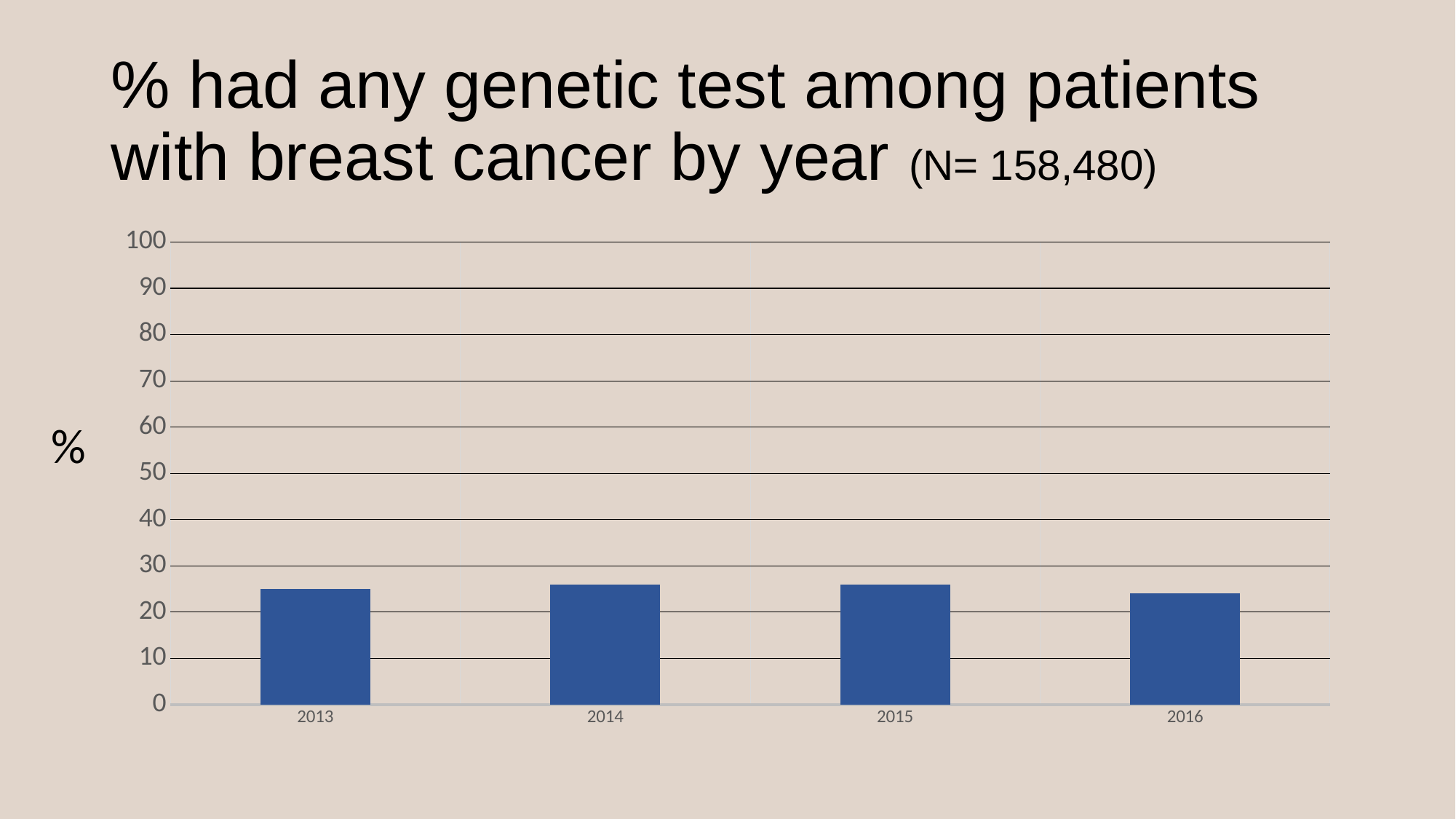
How many years are shown on the x axis of the chart? 4 Is the value for 2016 greater or less than 50? less What is the first year shown on the x axis? 2013 What is the sample size (N) given in the chart title? 158,480 Is the value for 2014 greater or less than 30? less What kind of chart is shown on the slide? bar chart Is the value for 2015 greater or less than 20? greater Which is larger, the value for 2014 or the value for 2016? 2014